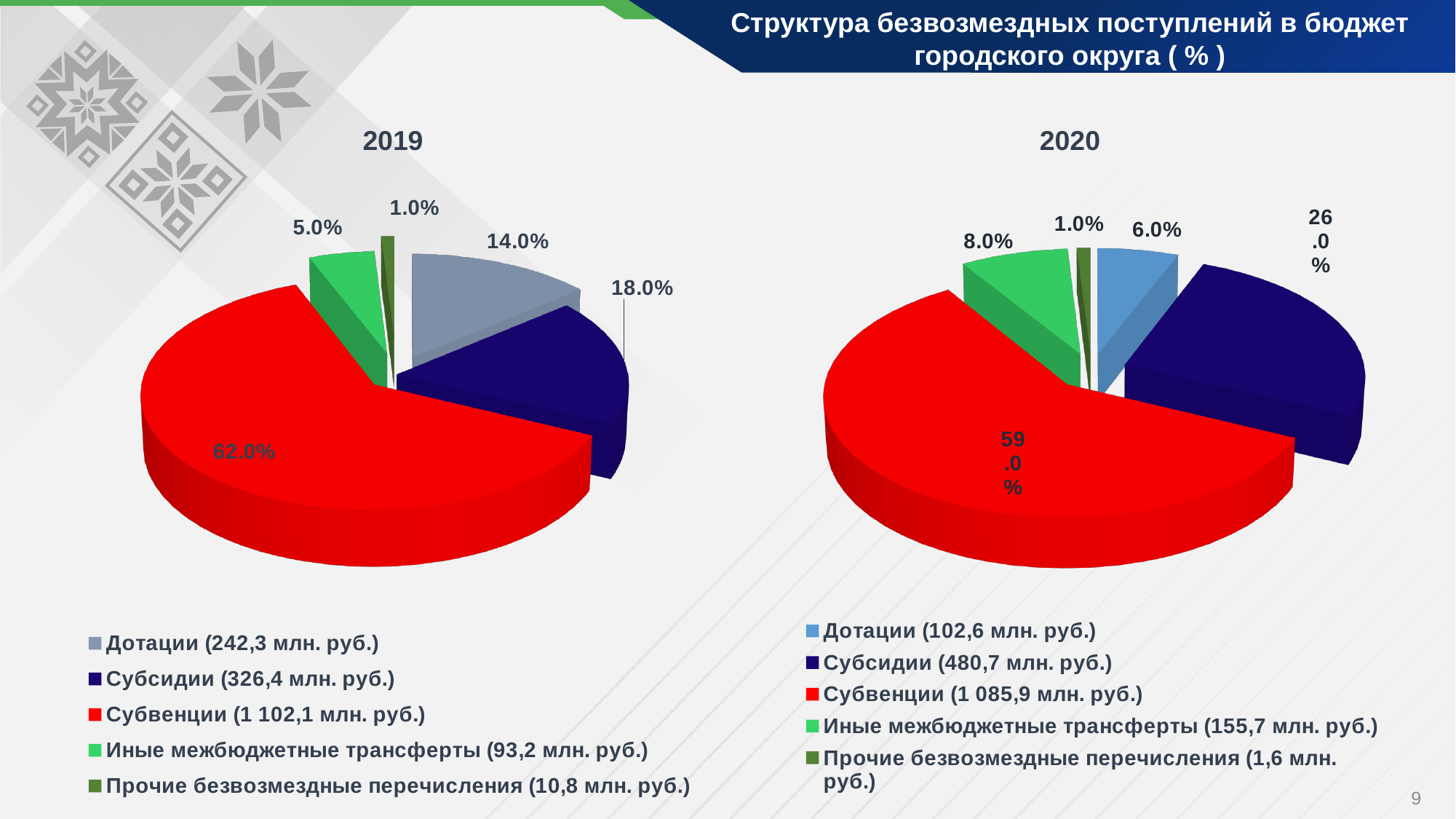
In the 2019 pie chart, what is the difference between the shares of Субсидии and Дотации? 4.0% In the 2020 pie chart, what share is shown for Иные межбюджетные трансферты? 8.0% How many categories does the 2020 pie chart show? 5 In the 2020 pie chart, which category has the smallest share? Прочие безвозмездные перечисления In the 2019 pie chart, which category has the largest share? Субвенции In the 2020 pie chart, what share is shown for Субсидии? 26.0% In the 2019 chart legend, what amount in million rubles is given for Субвенции? 1 102,1 млн. руб. In the 2019 pie chart, what share is shown for Дотации? 14.0% In the 2019 pie chart, what share is shown for Субвенции? 62.0% In the 2020 chart legend, what amount in million rubles is given for Дотации? 102,6 млн. руб. What type of chart is used for the 2019 data? Pie chart In the 2020 pie chart, which is larger: the share of Дотации or the share of Иные межбюджетные трансферты? Иные межбюджетные трансферты